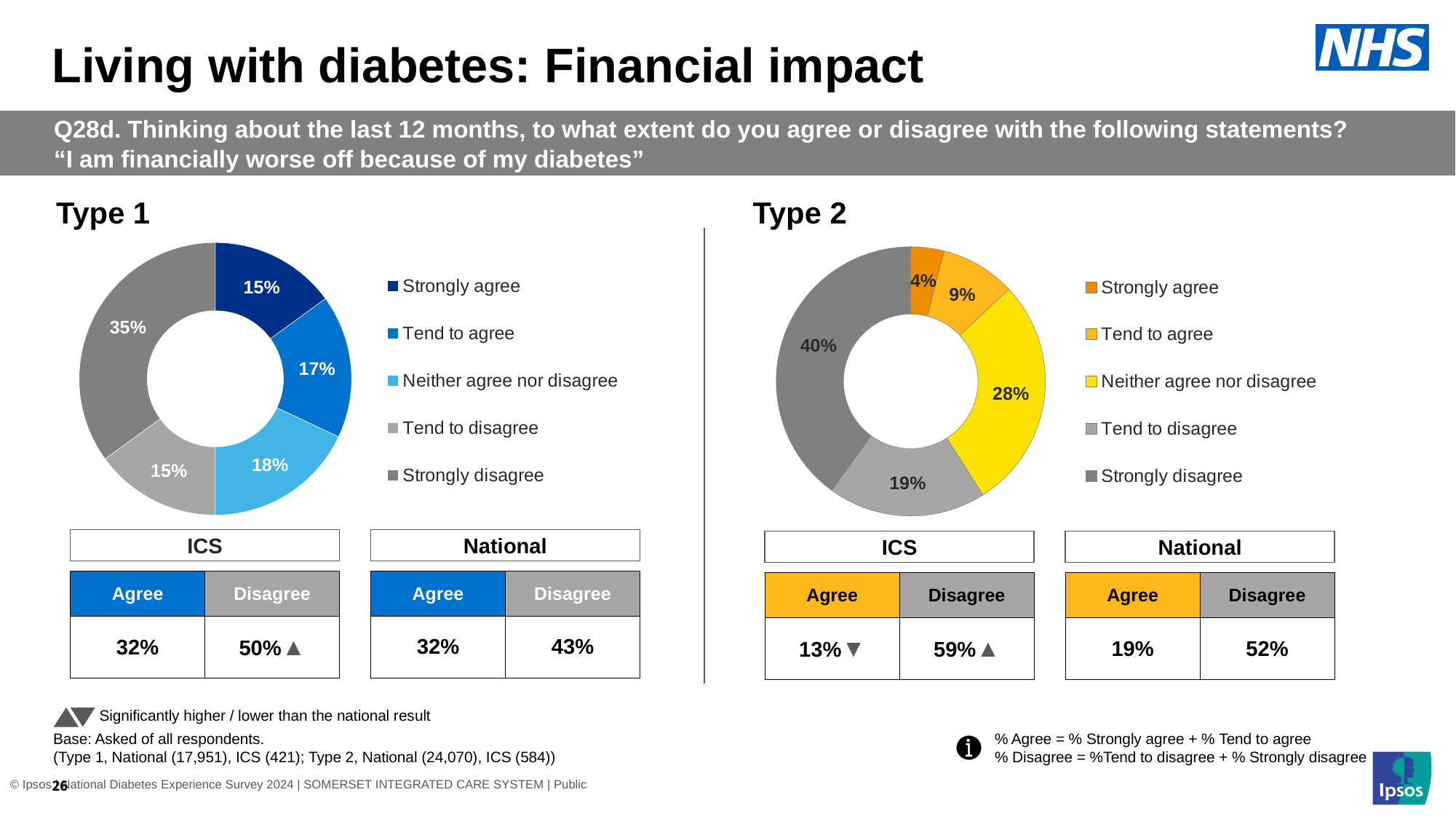
In the Type 2 chart, what colour represents 'Neither agree nor disagree'? Yellow How many response categories does the legend of the Type 2 chart list? 5 In the Type 2 chart, which response category has the smallest share? Strongly agree What type of chart is used to show the Type 1 results? Doughnut chart In the Type 1 chart, what is the difference between the 'Strongly disagree' share and the 'Strongly agree' share? 20% In the Type 1 chart, which response category has the largest share? Strongly disagree In the Type 2 chart, what is the difference between the 'Strongly disagree' share and the 'Tend to disagree' share? 21% In the Type 1 chart, what share of the pie does 'Tend to disagree' represent? 15% In the Type 1 chart, which is larger: 'Tend to agree' or 'Neither agree nor disagree'? Neither agree nor disagree In the Type 1 chart, what percentage of respondents said 'Strongly agree'? 15% In the Type 2 chart, what percentage of respondents said 'Neither agree nor disagree'? 28% In the Type 2 chart, what is the combined share of 'Strongly agree' and 'Tend to agree'? 13%